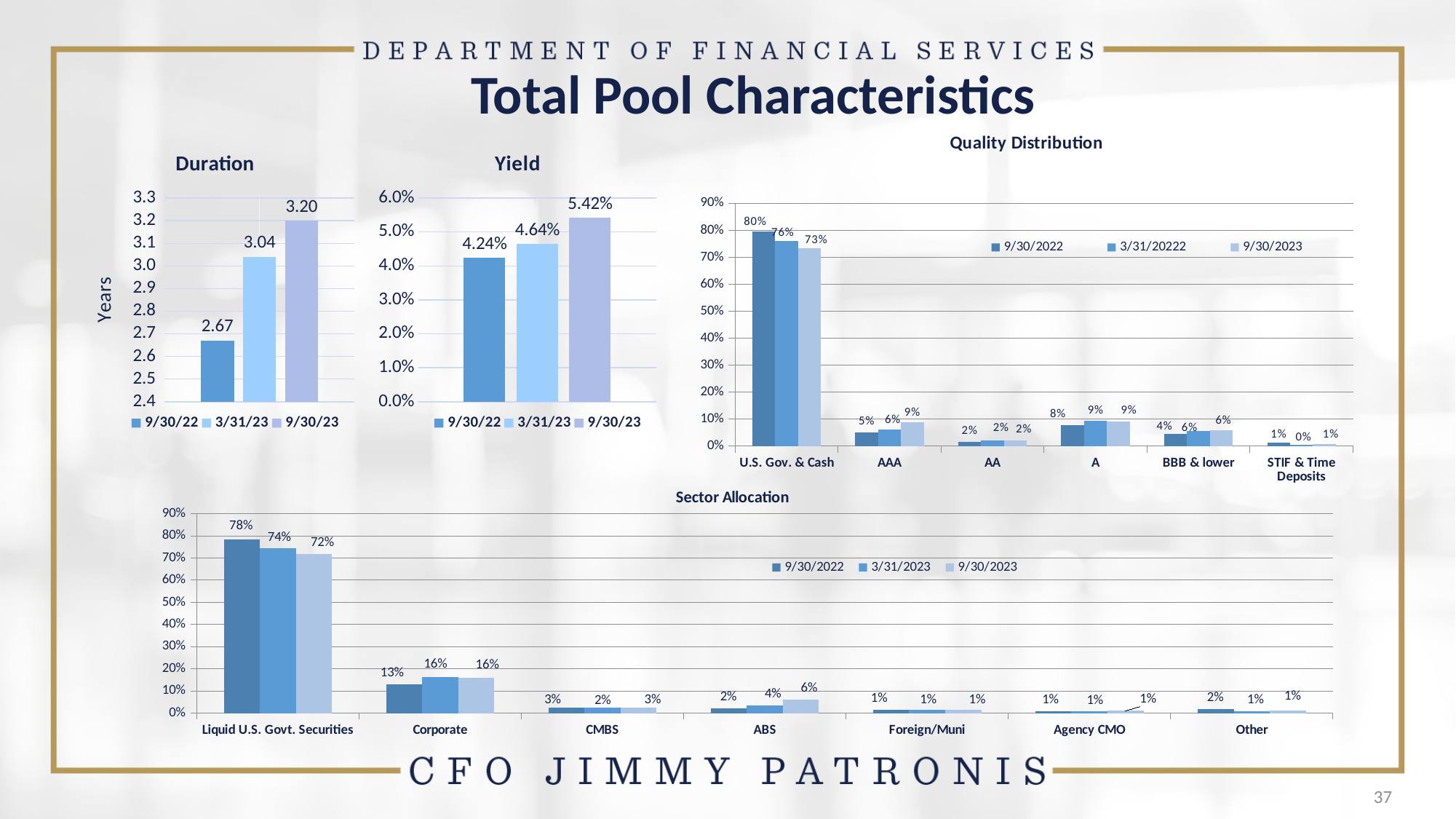
In the Yield chart, what is the difference between the 9/30/23 and 9/30/22 values? 1.18% In the Sector Allocation chart, what is the difference between the 9/30/2022 and 9/30/2023 values for Liquid U.S. Govt. Securities? 6% What kind of chart is the Sector Allocation chart? bar chart In the Quality Distribution chart, what is the 9/30/2023 value for U.S. Gov. & Cash? 73% In the Yield chart, what is the value for 3/31/23? 4.64% In the Duration chart, do the values rise or fall from 9/30/22 to 9/30/23? rise In the Quality Distribution chart, how many categories are shown on the x axis? 6 In the Quality Distribution chart, which category has the highest values? U.S. Gov. & Cash In the Sector Allocation chart, how many series does the legend list? 3 In the Duration chart, what is the value for 9/30/22? 2.67 In the Sector Allocation chart, what is the 9/30/2022 value for Corporate? 13% In the Duration chart, what is the value for 9/30/23? 3.20